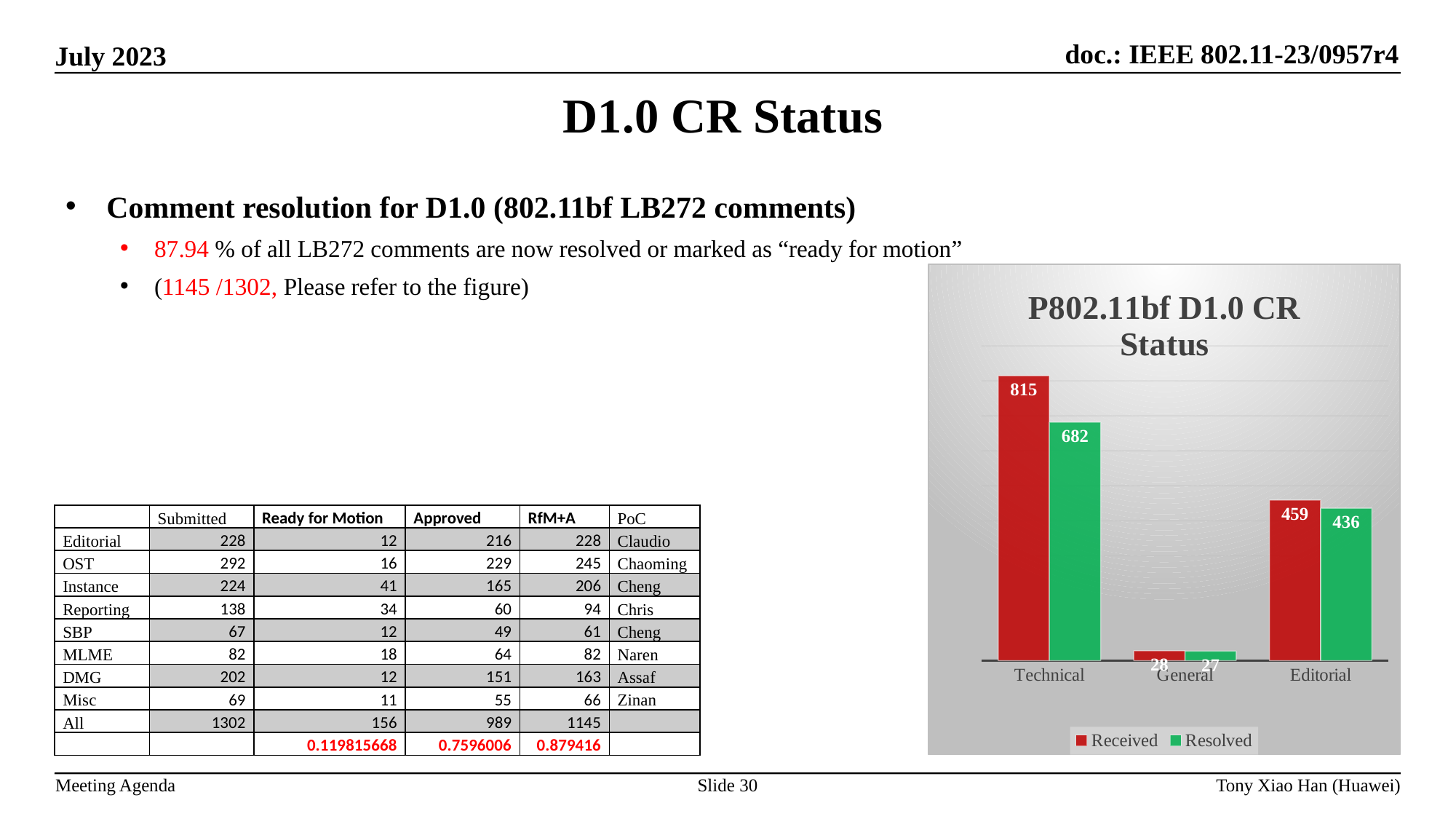
What is the Resolved value for Technical in the chart? 682 Is the Received value for Editorial larger or smaller than the Resolved value for Technical? smaller What is the Received value for Technical in the P802.11bf D1.0 CR Status chart? 815 What is the difference between Received and Resolved for Technical in the chart? 133 What type of chart is shown on the slide? bar chart How many categories are shown on the x axis of the chart? 3 How many series does the chart legend list? 2 Which category has the lowest Resolved value in the chart? General What is the difference between Received and Resolved for Editorial in the chart? 23 Which category has the highest Received value in the chart? Technical What is the Resolved value for Editorial in the P802.11bf D1.0 CR Status chart? 436 What is the Received value for General in the chart? 28